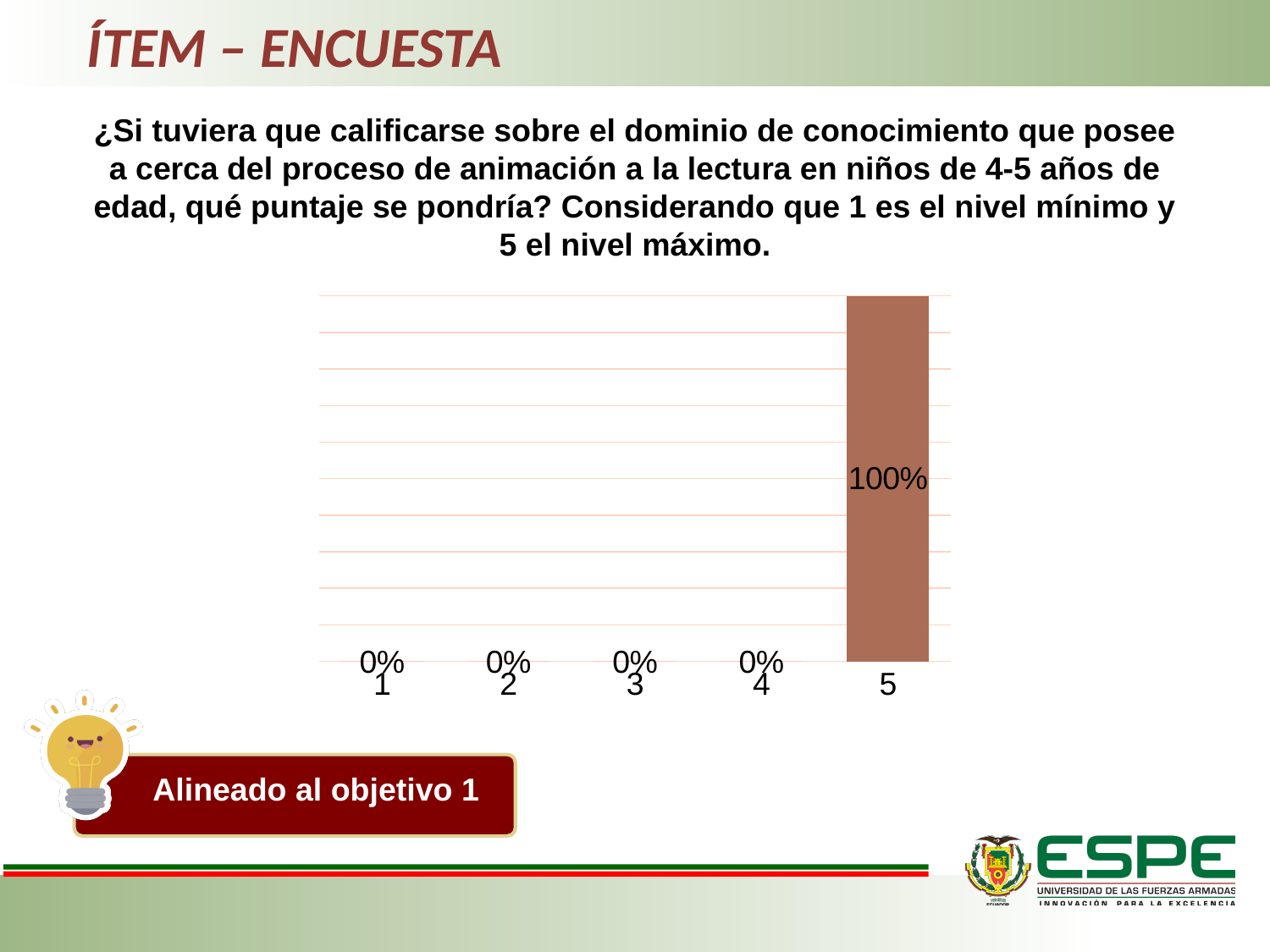
Which category has the highest value? 5 What is the difference between the values for category 5 and category 4? 100% Which is larger, the value for category 5 or the value for category 2? 5 What colour is the bar for category 5? brown What is the value for category 1? 0% What kind of chart is shown on the slide? bar chart What is the value for category 5? 100% What is the value for category 4? 0% What is the value for category 3? 0% How many categories have a value of 0%? 4 How many categories are shown on the x axis? 5